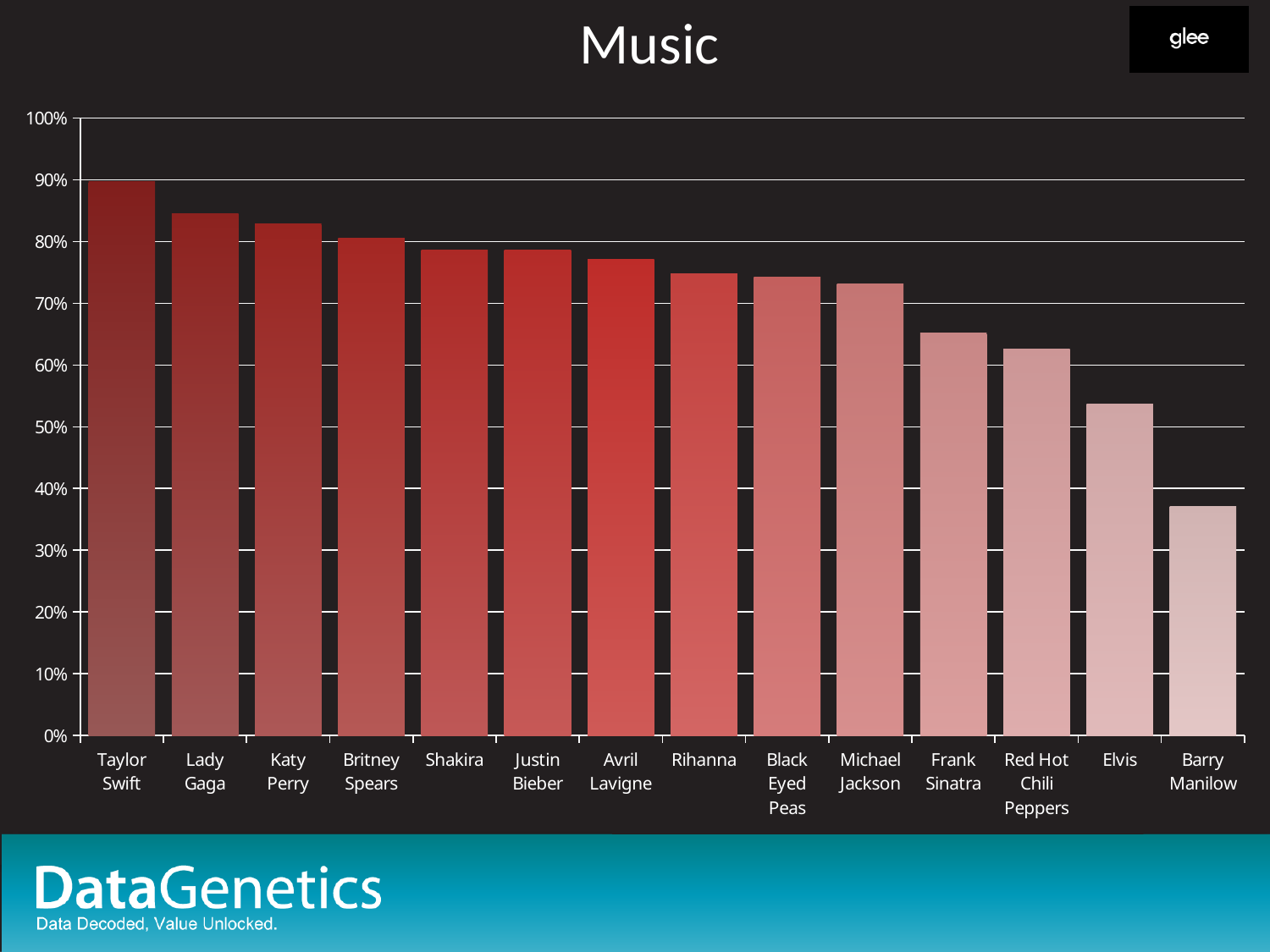
Is the value for Elvis greater or less than 50%? greater Do the values rise or fall moving from left to right along the x axis? fall Is the value for Barry Manilow greater or less than 40%? less Which has a larger value, Lady Gaga or Rihanna? Lady Gaga How many artists are shown on the x axis of the chart? 14 Which artist has the lowest value in the chart? Barry Manilow What is the title of the chart? Music Is the value for Taylor Swift greater or less than 80%? greater Which artist has the highest value in the chart? Taylor Swift What type of chart is shown on the slide? bar chart